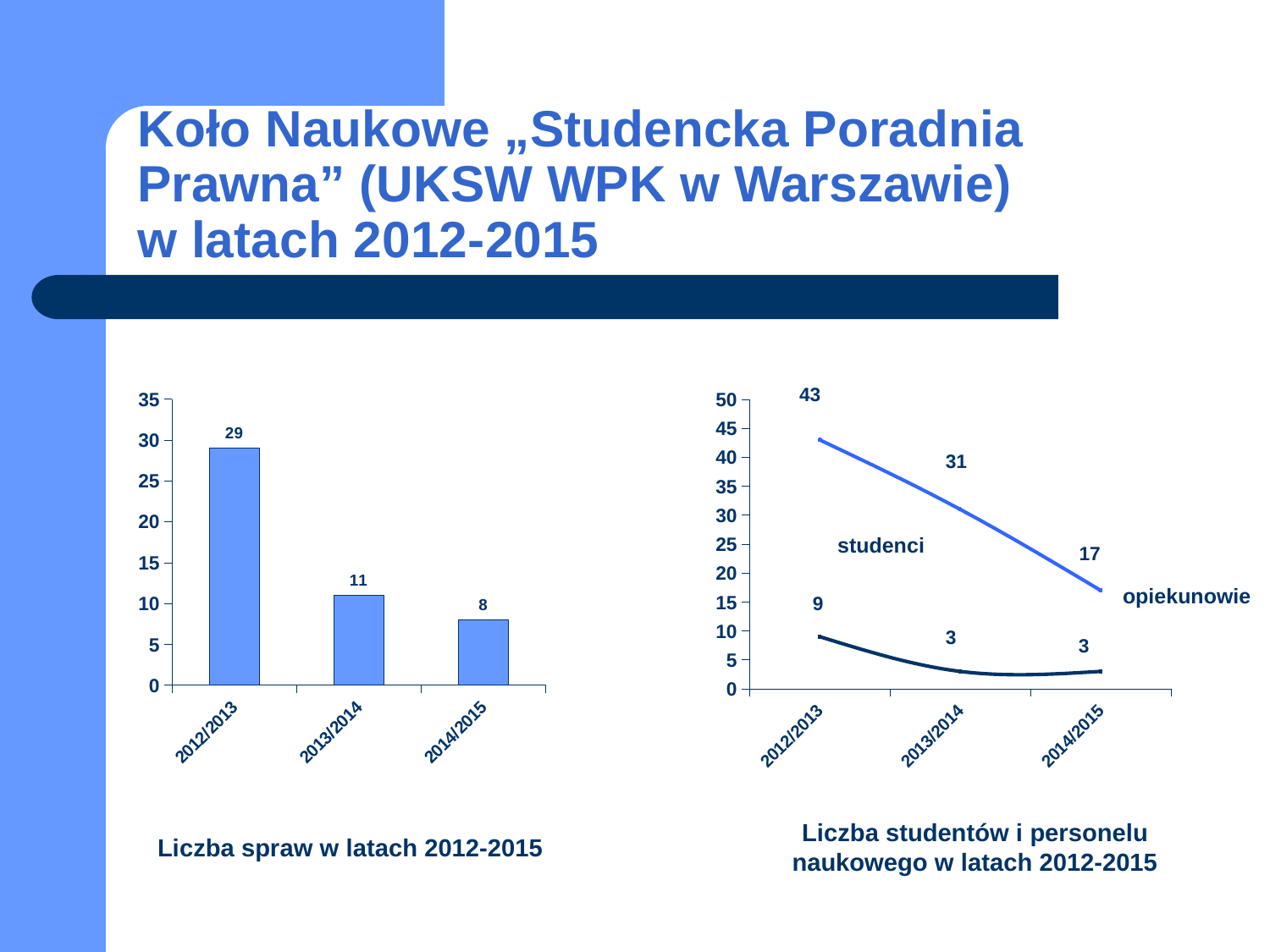
In the right chart (Liczba studentów i personelu naukowego w latach 2012-2015), what is the difference between studenci and opiekunowie in 2014/2015? 14 In the right chart (Liczba studentów i personelu naukowego w latach 2012-2015), what is the value for studenci in 2013/2014? 31 In the right chart (Liczba studentów i personelu naukowego w latach 2012-2015), which series is larger in 2012/2013, studenci or opiekunowie? studenci What kind of chart is the right chart (Liczba studentów i personelu naukowego w latach 2012-2015)? line chart In the left chart (Liczba spraw w latach 2012-2015), which year has the highest value? 2012/2013 What kind of chart is the left chart (Liczba spraw w latach 2012-2015)? bar chart In the right chart (Liczba studentów i personelu naukowego w latach 2012-2015), what is the value for opiekunowie in 2012/2013? 9 In the left chart (Liczba spraw w latach 2012-2015), what is the value for 2012/2013? 29 In the left chart (Liczba spraw w latach 2012-2015), do the values rise or fall from 2012/2013 to 2014/2015? fall In the left chart (Liczba spraw w latach 2012-2015), how many bars are there? 3 In the left chart (Liczba spraw w latach 2012-2015), what is the difference between the values for 2012/2013 and 2013/2014? 18 In the left chart (Liczba spraw w latach 2012-2015), what is the value for 2014/2015? 8